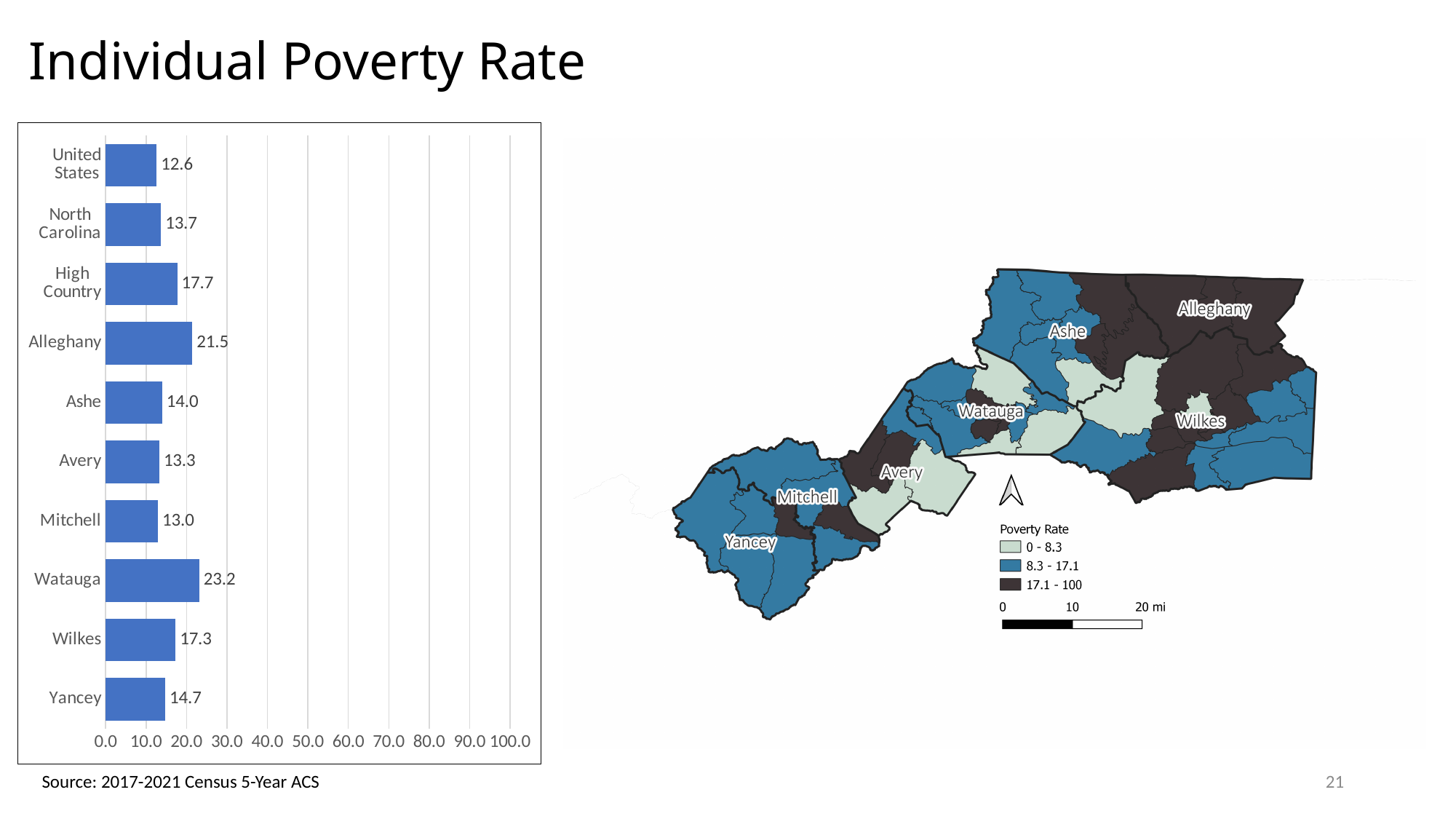
What is the individual poverty rate shown for High Country? 17.7 What kind of chart is used to show the individual poverty rates? Bar chart Which category has the highest individual poverty rate in the bar chart? Watauga What is the individual poverty rate shown for Watauga? 23.2 Is the value for Alleghany greater or less than 20.0? greater What is the difference between the poverty rates of Watauga and Alleghany? 1.7 How many categories are shown in the bar chart? 10 What is the highest value shown on the x axis of the bar chart? 100.0 Which category has the lowest individual poverty rate in the bar chart? United States What is the individual poverty rate shown for the United States? 12.6 Which has a higher individual poverty rate, Wilkes or Yancey? Wilkes What is the difference between the poverty rates of North Carolina and the United States? 1.1